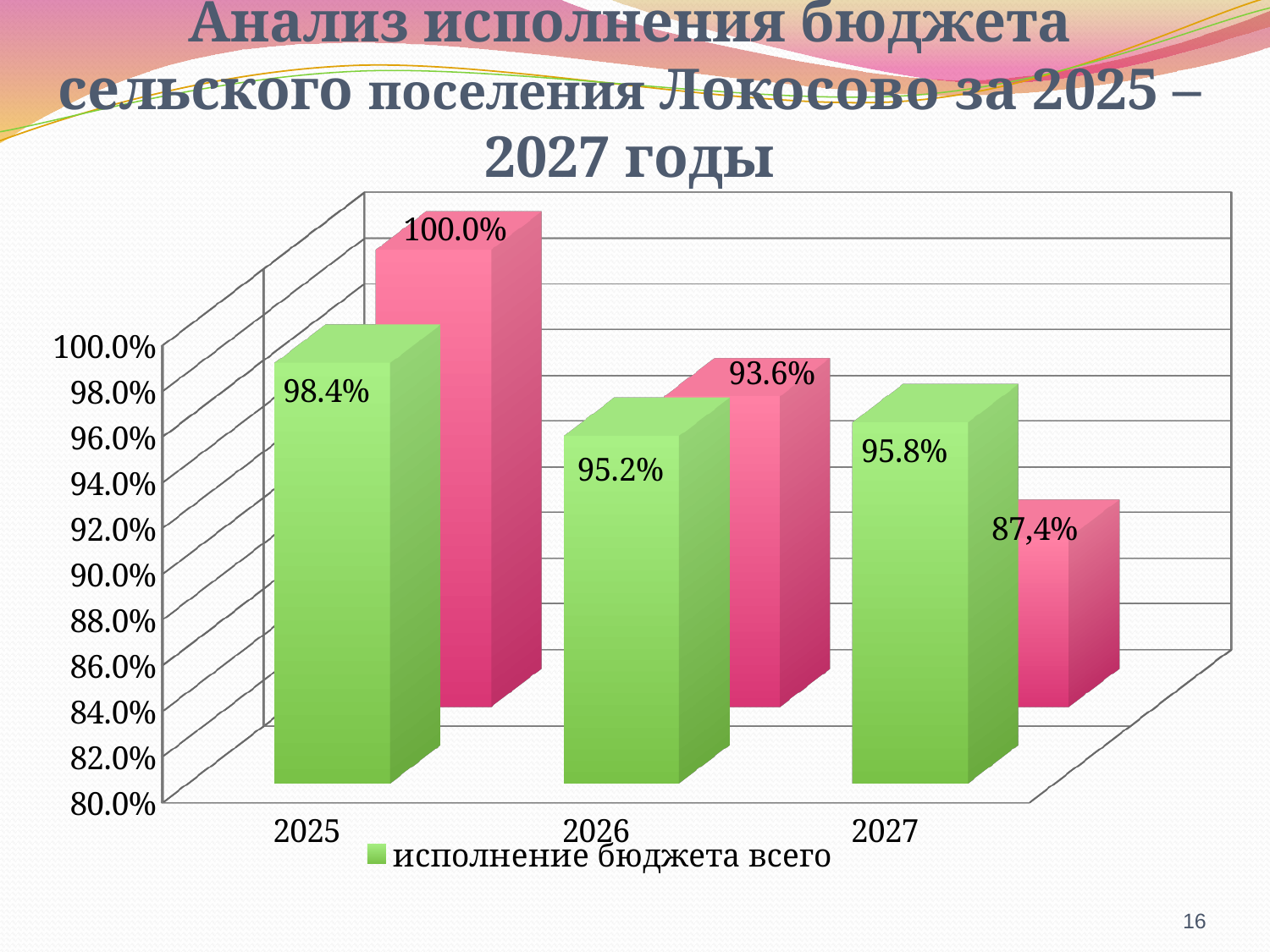
What is the value of the green bar (исполнение бюджета всего) for 2025? 98.4% What is the difference between the green bar values for 2025 and 2026? 3.2% What is the value of the pink bar for 2025? 100.0% What is the value of the green bar (исполнение бюджета всего) for 2026? 95.2% What is the value of the pink bar for 2027? 87,4% In which year is the pink series lowest? 2027 What kind of chart is shown on the slide? bar chart How many years are shown on the x axis? 3 Do the pink bar values rise or fall from 2025 to 2027? fall What is the value of the green bar (исполнение бюджета всего) for 2027? 95.8% For 2027, which is larger: the green bar or the pink bar? the green bar (95.8%) In which year is the green series (исполнение бюджета всего) highest? 2025